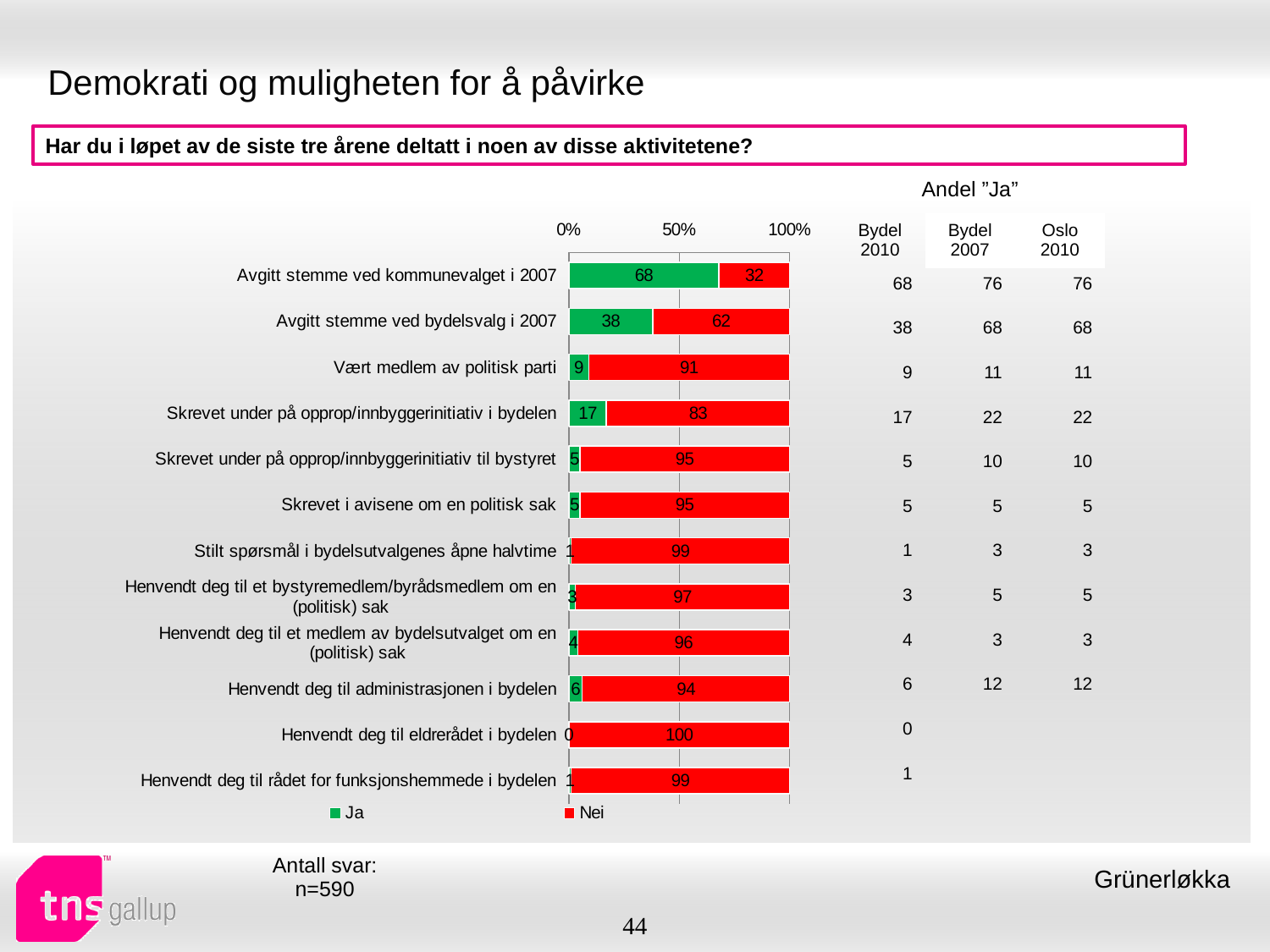
What is the "Nei" value for "Avgitt stemme ved bydelsvalg i 2007"? 62 How many categories (activities) are plotted in the chart? 12 Which series is shown in red in the chart? Nei What is the "Ja" value for "Skrevet under på opprop/innbyggerinitiativ i bydelen"? 17 What kind of chart is shown on the slide? bar chart How many series does the chart's legend list? 2 Which category has the lowest "Ja" value? Henvendt deg til eldrerådet i bydelen Which category has the highest "Ja" value? Avgitt stemme ved kommunevalget i 2007 Which has a larger "Ja" value: "Vært medlem av politisk parti" or "Henvendt deg til administrasjonen i bydelen"? Vært medlem av politisk parti What is the difference between the "Ja" values for "Avgitt stemme ved kommunevalget i 2007" and "Avgitt stemme ved bydelsvalg i 2007"? 30 What is the "Ja" value for "Avgitt stemme ved kommunevalget i 2007"? 68 What is the total of the stacked bar for "Vært medlem av politisk parti"? 100